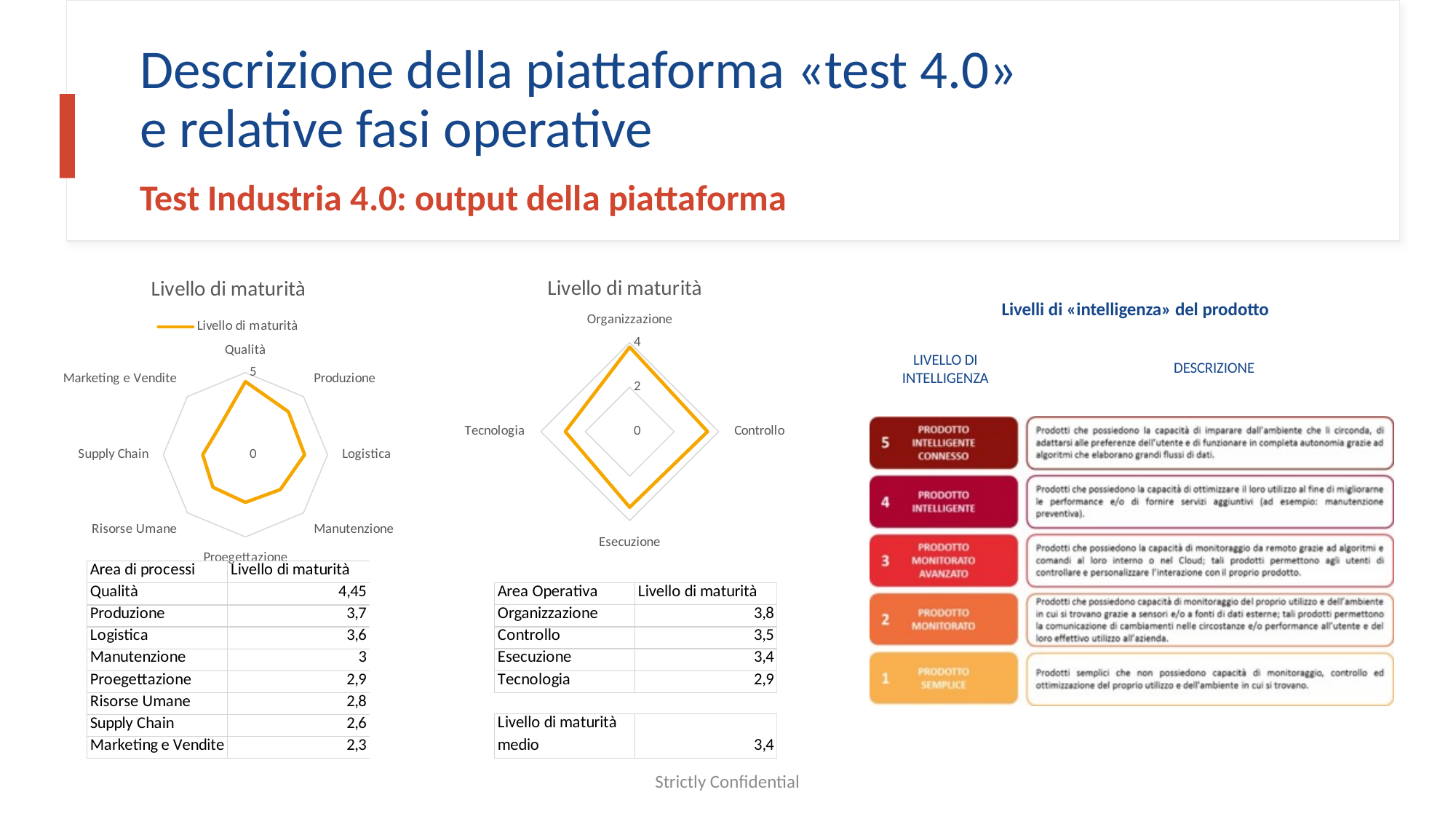
What kind of chart is the left chart titled "Livello di maturità"? radar chart In the middle radar chart, is the value for Tecnologia greater or less than 4? less How many categories does the left radar chart (with Qualità, Produzione, etc.) have? 8 In the left radar chart, which is larger: the value for Produzione or the value for Supply Chain? Produzione In the middle radar chart, which area has the highest Livello di maturità? Organizzazione How many categories does the middle radar chart (with Organizzazione, Controllo, Esecuzione, Tecnologia) have? 4 In the middle radar chart, what is the Livello di maturità value for Controllo? 3,5 In the left radar chart, what is the Livello di maturità value for Qualità? 4,45 In the left radar chart, which category has the lowest Livello di maturità? Marketing e Vendite In the left radar chart, which category has the highest Livello di maturità? Qualità How many series does the legend of the left radar chart list? 1 In the middle radar chart, what is the difference between the values for Organizzazione and Tecnologia? 0,9